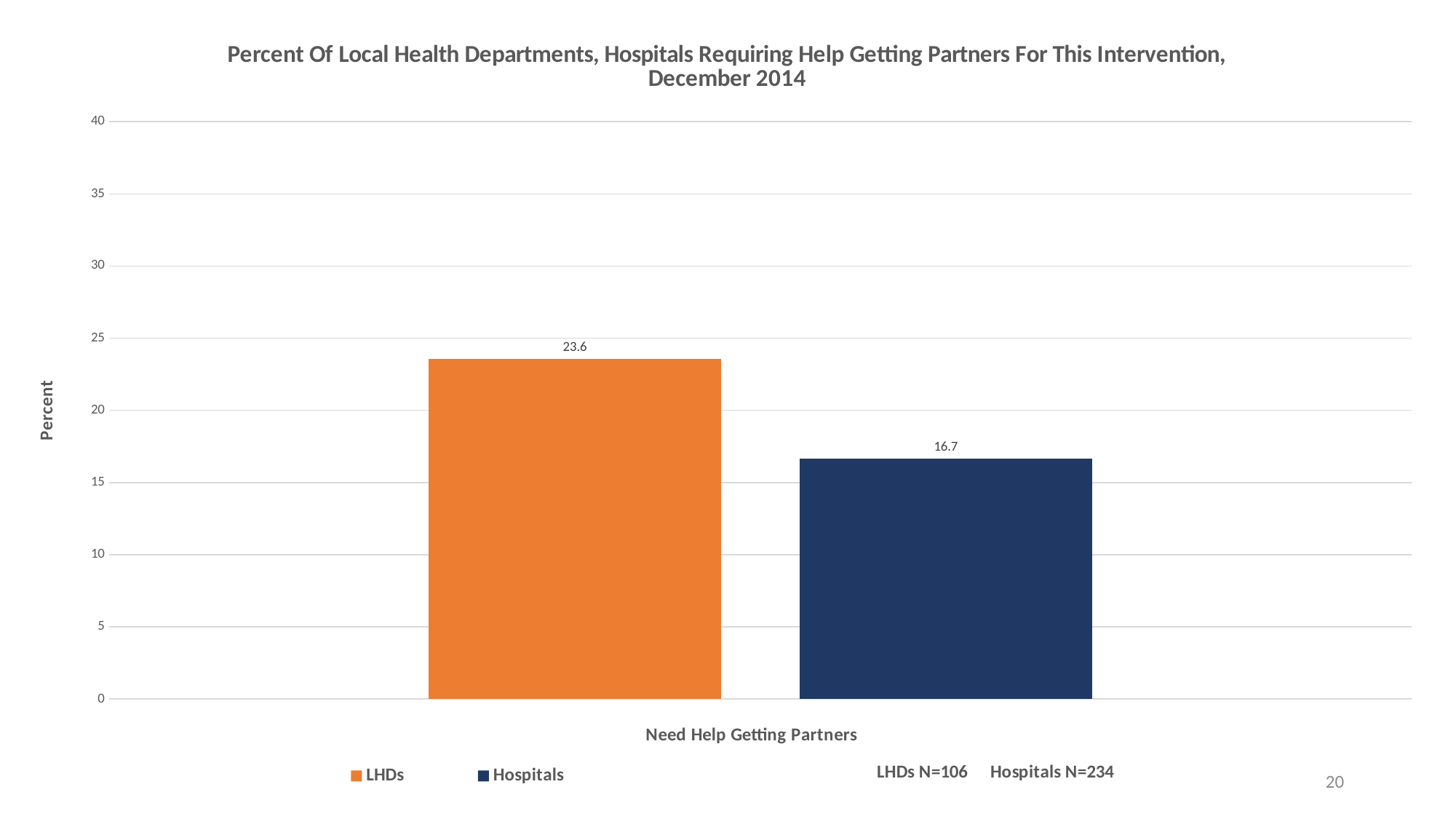
How many categories are shown on the x axis? 1 What is the label of the y axis? Percent What is the value for Hospitals in the Need Help Getting Partners category? 16.7 How many series does the legend list? 2 What colour is the bar for Hospitals? Dark blue Is the value for LHDs greater or less than 20? greater Is the value for Hospitals greater or less than 20? less What kind of chart is shown on the slide? Bar chart What is the difference between the LHDs value and the Hospitals value? 6.9 What is the value for LHDs in the Need Help Getting Partners category? 23.6 Which series has the lowest value on the chart? Hospitals Which series has the higher value, LHDs or Hospitals? LHDs